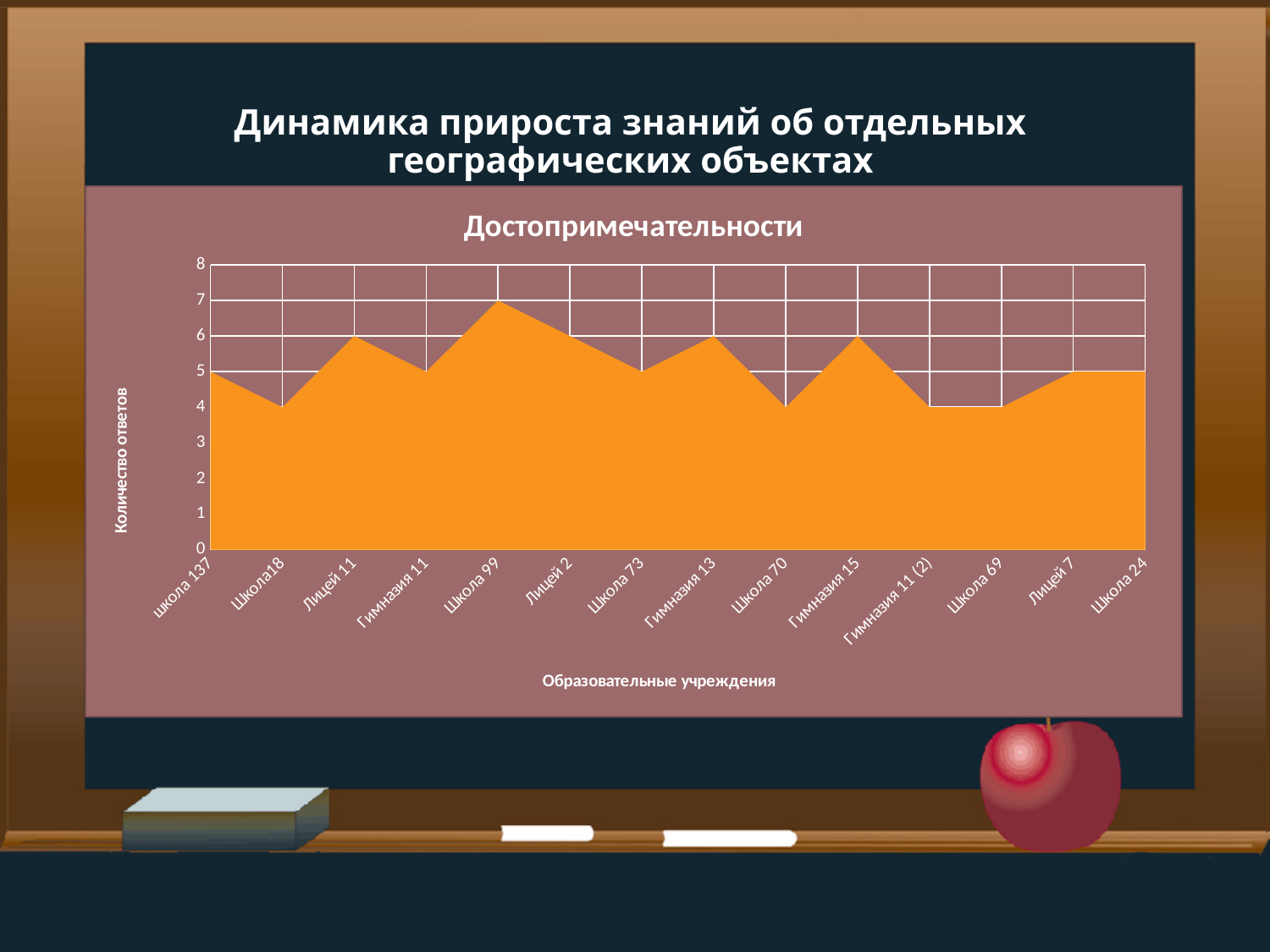
What is the label of the vertical axis? Количество ответов Which has a larger value, Гимназия 15 or Школа 70? Гимназия 15 What is the difference between the values for Школа 99 and Школа18? 3 What is the title of the chart? Достопримечательности Which educational institution has the highest value? Школа 99 What is the value for Школа 69? 4 What type of chart is shown on the slide? area chart How many educational institutions are plotted along the x axis? 14 Is the value for Гимназия 11 (2) greater or less than 5? less What is the value for школа 137? 5 What is the value for Школа 99? 7 What is the value for Лицей 11? 6